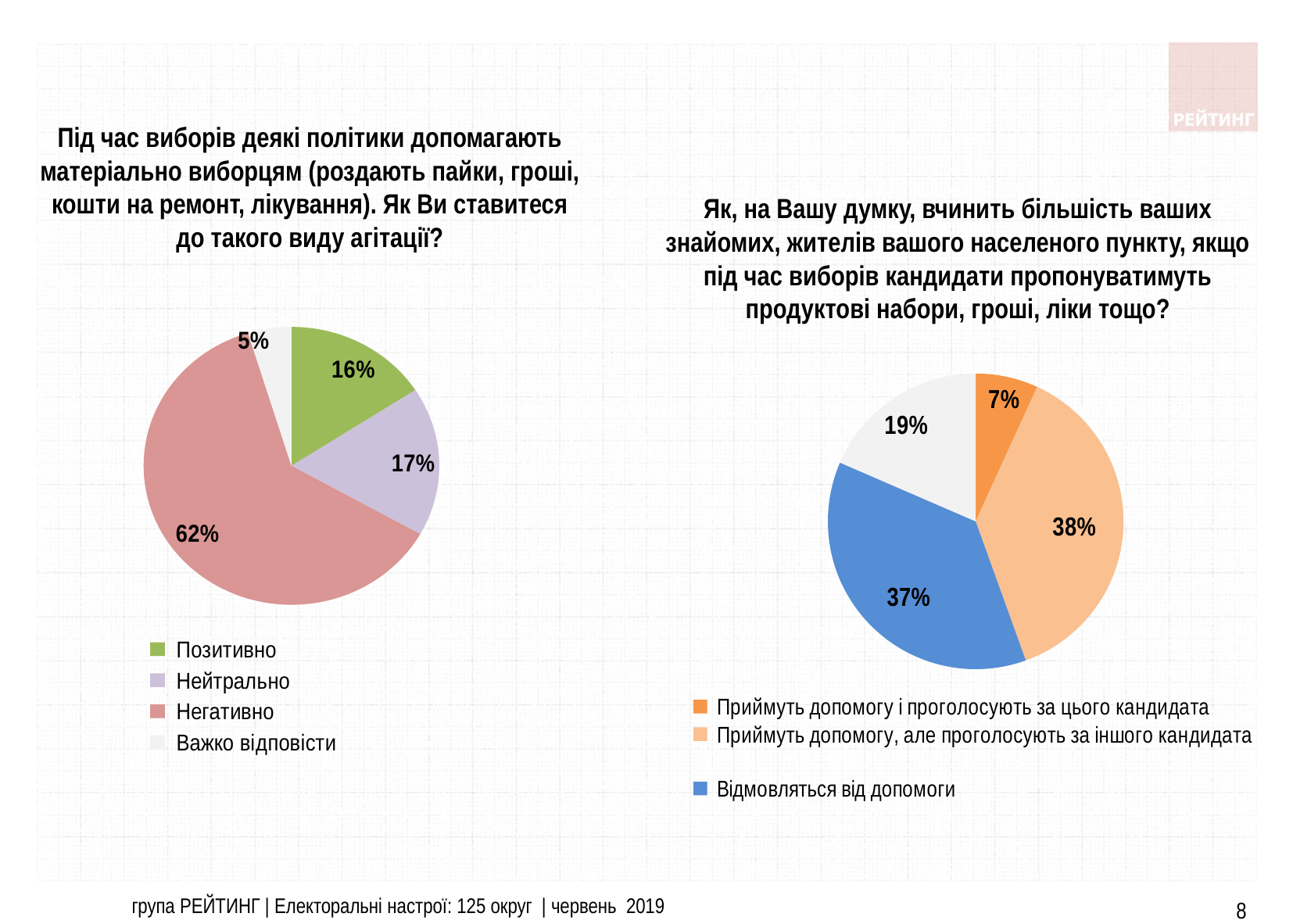
On the right pie chart, what share of respondents chose "Приймуть допомогу і проголосують за цього кандидата"? 7% On the left pie chart, what is the difference between the "Негативно" and "Позитивно" shares? 46 percentage points On the left pie chart, what share of respondents answered "Позитивно"? 16% How many slices does the left pie chart have? 4 On the left pie chart, which category has the smallest share? Важко відповісти On the left pie chart, what share of respondents answered "Негативно"? 62% On the right pie chart, what share of respondents chose "Приймуть допомогу, але проголосують за іншого кандидата"? 38% On the right pie chart, what share of respondents chose "Відмовляться від допомоги"? 37% On the left pie chart, which category has the largest share? Негативно On the left pie chart, what share of respondents answered "Нейтрально"? 17% On the right pie chart, how many entries does the legend list? 3 What type of chart is used on the right side of the slide? Pie chart